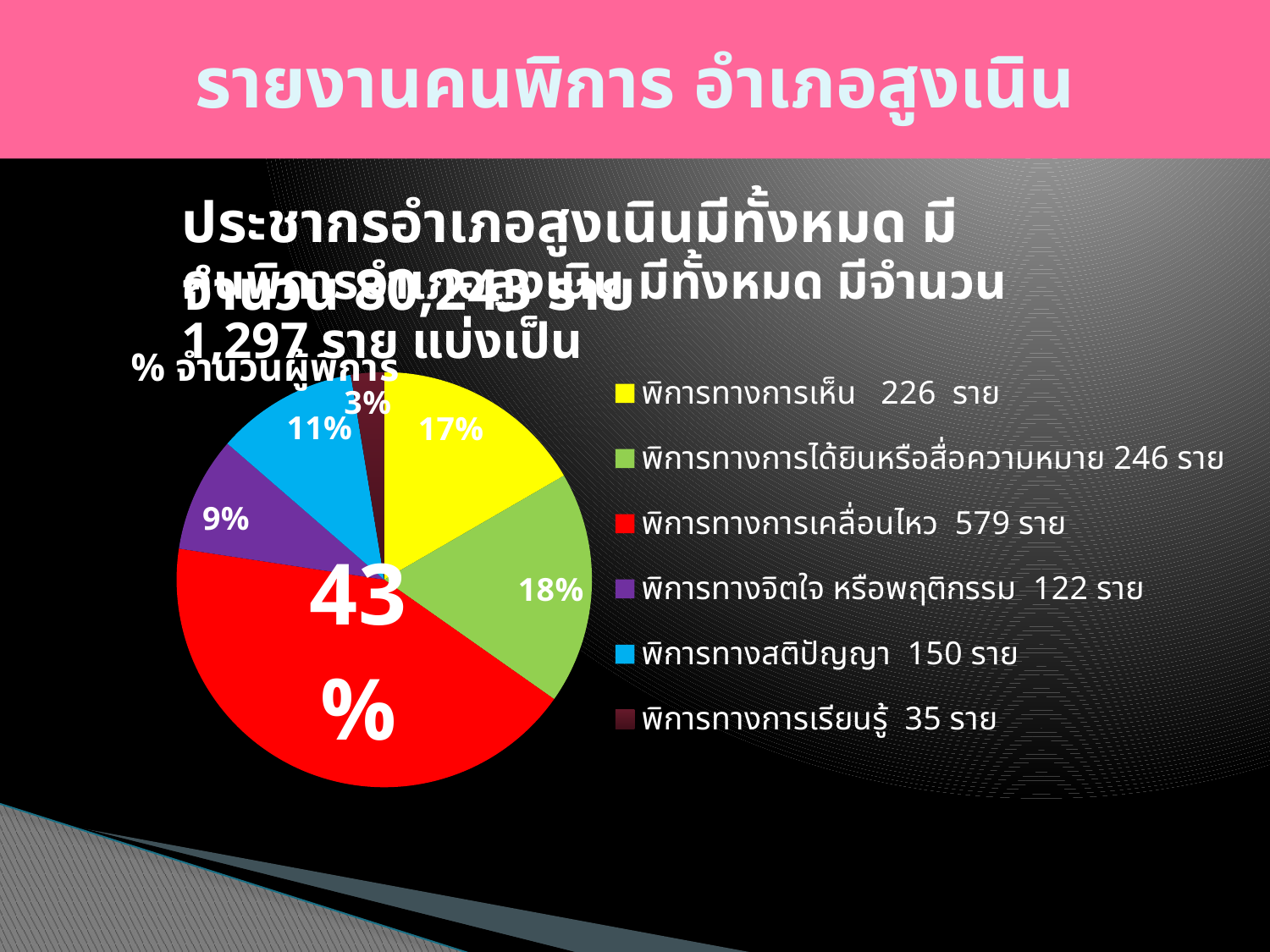
What percentage does the slice for พิการทางการเห็น show? 17% Which category has the smallest slice of the pie? พิการทางการเรียนรู้ How many slices does the pie chart have? 6 What percentage does the slice for พิการทางการเคลื่อนไหว show? 43% What colour is the slice for พิการทางสติปัญญา? blue Which slice is larger: พิการทางการได้ยินหรือสื่อความหมาย or พิการทางจิตใจ หรือพฤติกรรม? พิการทางการได้ยินหรือสื่อความหมาย According to the legend, how many cases (ราย) are listed for พิการทางจิตใจ หรือพฤติกรรม? 122 ราย What percentage does the slice for พิการทางสติปัญญา show? 11% What is the difference in percentage points between the พิการทางการเคลื่อนไหว slice and the พิการทางการได้ยินหรือสื่อความหมาย slice? 25 What kind of chart is shown on the slide? pie chart Which category has the largest slice of the pie? พิการทางการเคลื่อนไหว What percentage does the slice for พิการทางการเรียนรู้ show? 3%